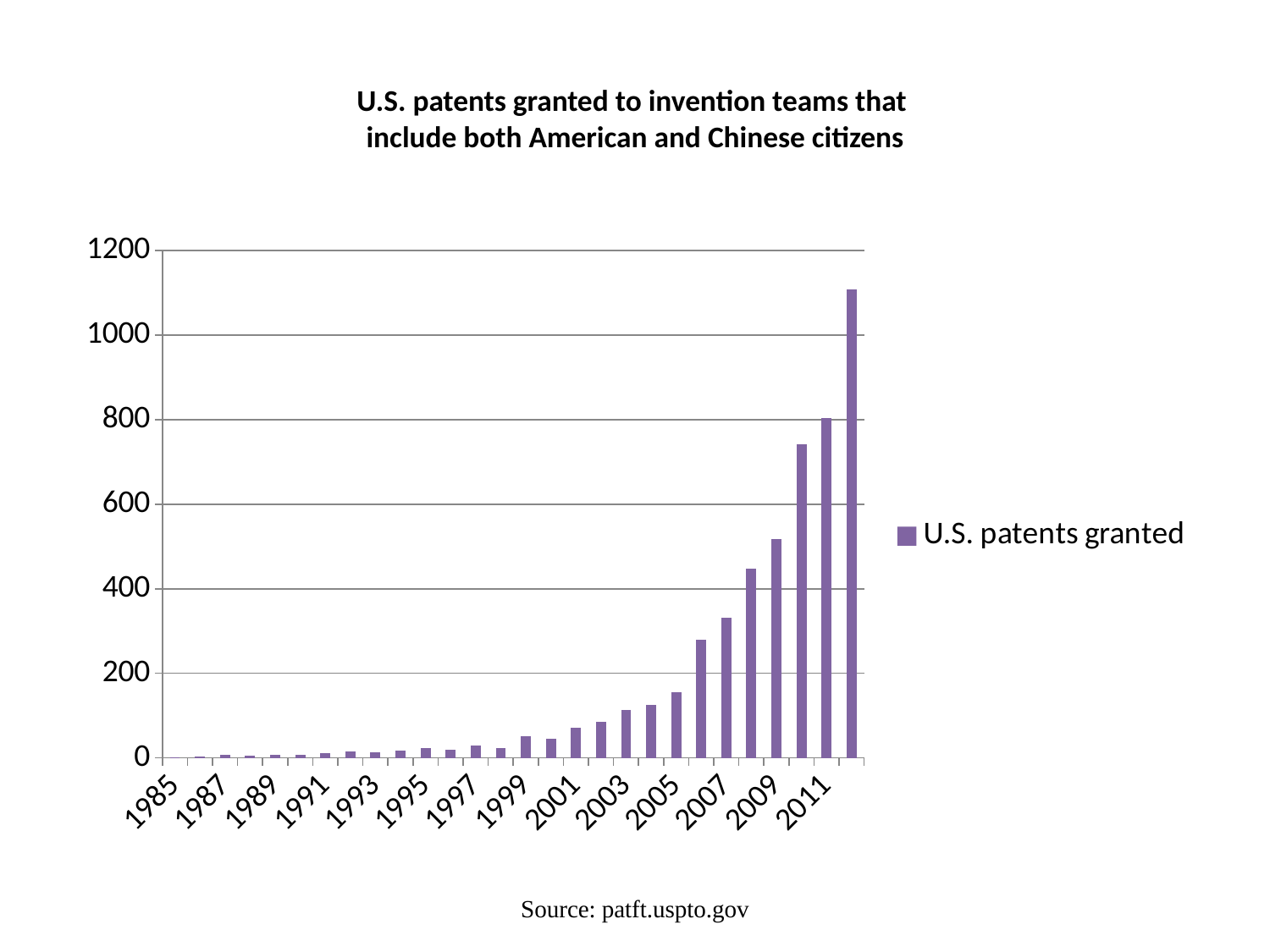
Is the value for 2010 greater or less than 600? greater Is the value for 2012 greater or less than 1000? greater How many series does the legend list? 1 Is the value for 2009 greater or less than 600? less Which year has the larger value, 2009 or 2007? 2009 Which year has the highest number of U.S. patents granted? 2012 What is the name of the series shown in the legend? U.S. patents granted What kind of chart is shown on the slide? bar chart Do the values generally rise or fall from 1985 to 2012? rise